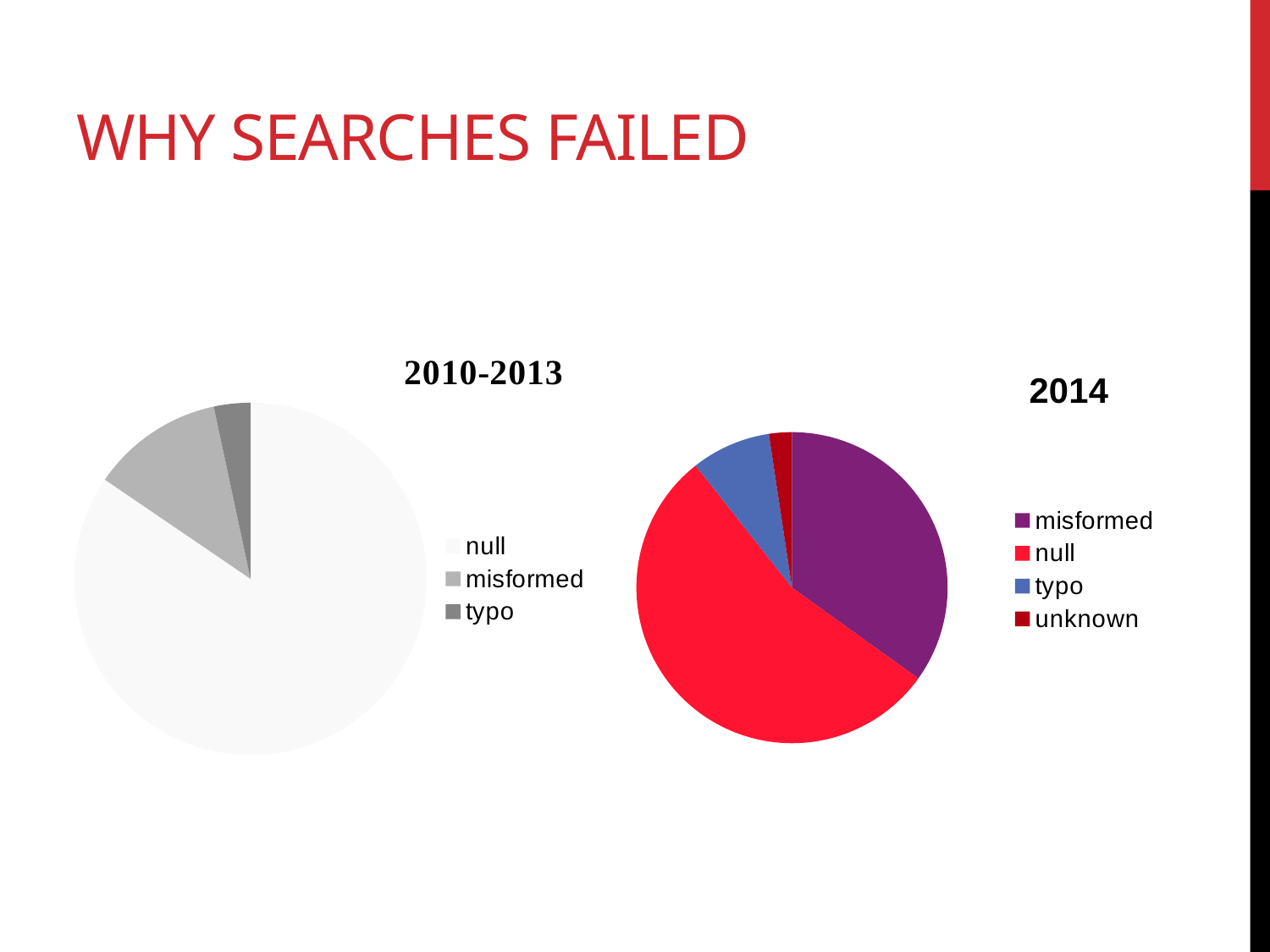
In the "2014" chart, how many categories does the legend list? 4 In the "2010-2013" chart, which slice is larger, misformed or typo? misformed In the "2014" chart, which category has the smallest slice? unknown In the "2014" chart, which category has the largest slice? null In the "2010-2013" chart, how many categories does the legend list? 3 What kind of chart is the "2010-2013" chart? pie chart In the "2010-2013" chart, which category has the smallest slice? typo In the "2014" chart, which slice is larger, misformed or typo? misformed Which category appears in the "2014" chart's legend but not in the "2010-2013" chart's legend? unknown In the "2010-2013" chart, which category has the largest slice? null In the "2014" chart, what colour is the null slice? red What kind of chart is the "2014" chart? pie chart